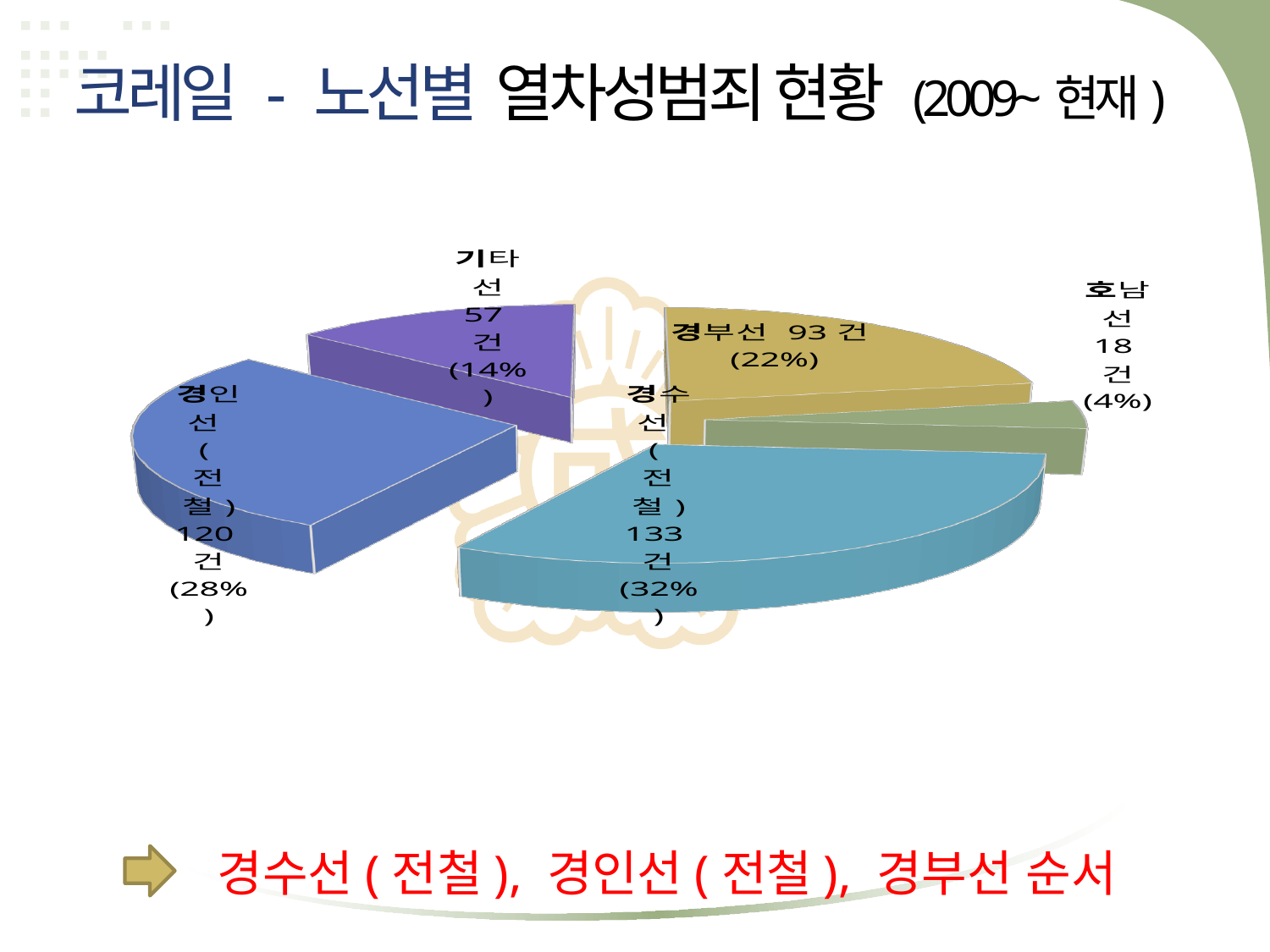
How many slices does the pie chart have? 5 What is the difference in cases between 경수선(전철) and 경인선(전철)? 13 건 How many cases are shown for 호남선? 18 건 Which has more cases, 경부선 or 기타선? 경부선 How many cases are shown for 경부선? 93 건 Which line has the highest number of cases? 경수선(전철) How many cases are shown for 경수선(전철)? 133 건 What share of the pie does 기타선 represent? 14% How many cases are shown for 경인선(전철)? 120 건 What kind of chart is shown on the slide? Pie chart What share of the pie does 경수선(전철) represent? 32% Which line has the lowest number of cases? 호남선